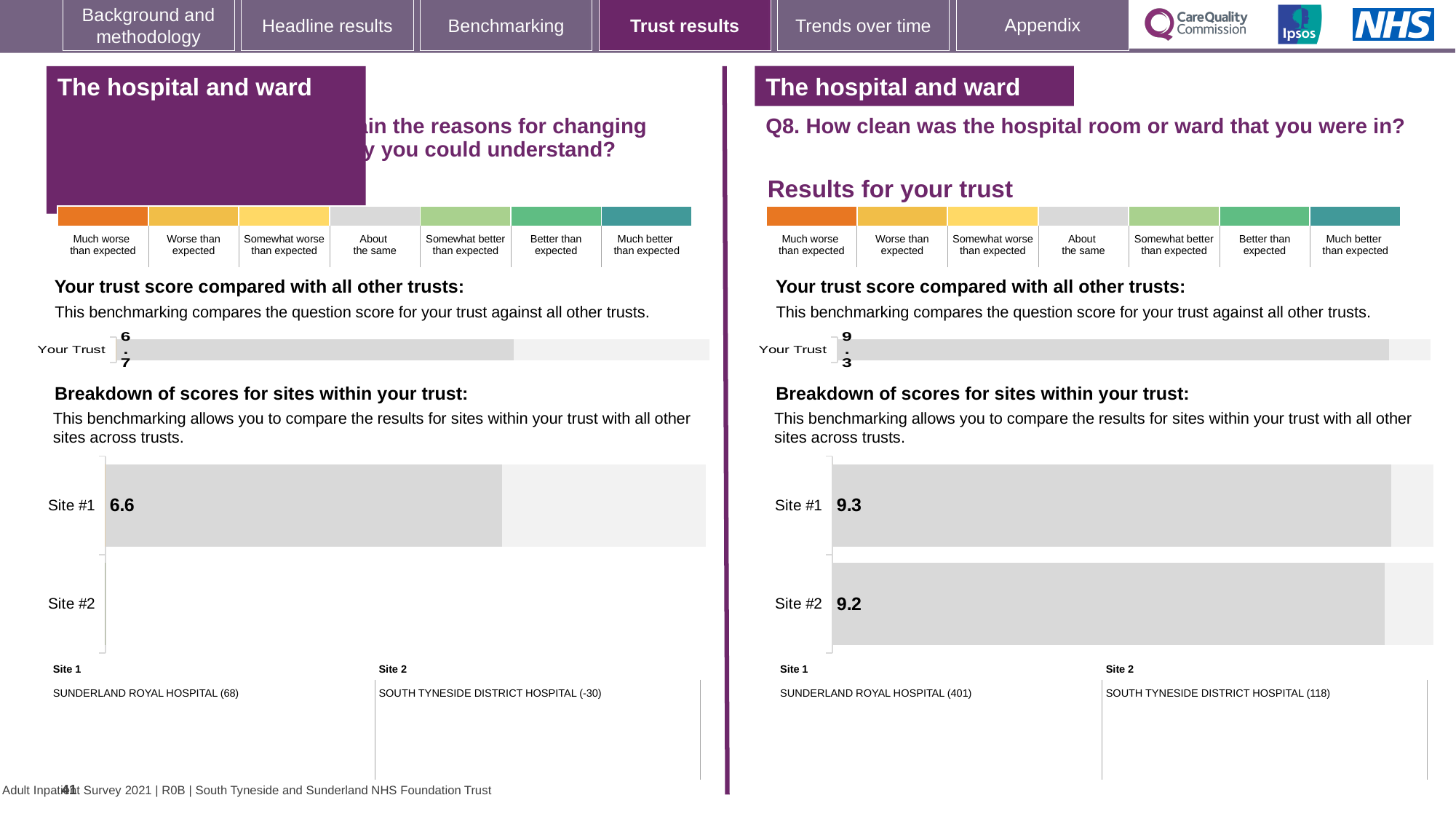
On the left-hand chart, what is the score shown for Your Trust? 6.7 On the right-hand Q8 site breakdown chart, what is the score for Site #2? 9.2 On the right-hand Q8 site breakdown chart, what is the difference between the Site #1 and Site #2 scores? 0.1 On the left-hand site breakdown chart, how many sites are listed? 2 What type of chart is used for the site breakdown on the right-hand side of the slide? Bar chart On the right-hand Q8 site breakdown chart, what is the score for Site #1? 9.3 On the right-hand chart for Q8 (How clean was the hospital room or ward), what is the score shown for Your Trust? 9.3 On the right-hand Q8 site breakdown chart, which site has the higher score? Site #1 On the right-hand Q8 site breakdown chart, which hospital is Site 1? SUNDERLAND ROYAL HOSPITAL On the left-hand site breakdown chart, what is the score for Site #1? 6.6 On the right-hand Q8 site breakdown chart, which hospital is Site 2? SOUTH TYNESIDE DISTRICT HOSPITAL On the left-hand site breakdown chart, which site has a score printed on its bar? Site #1